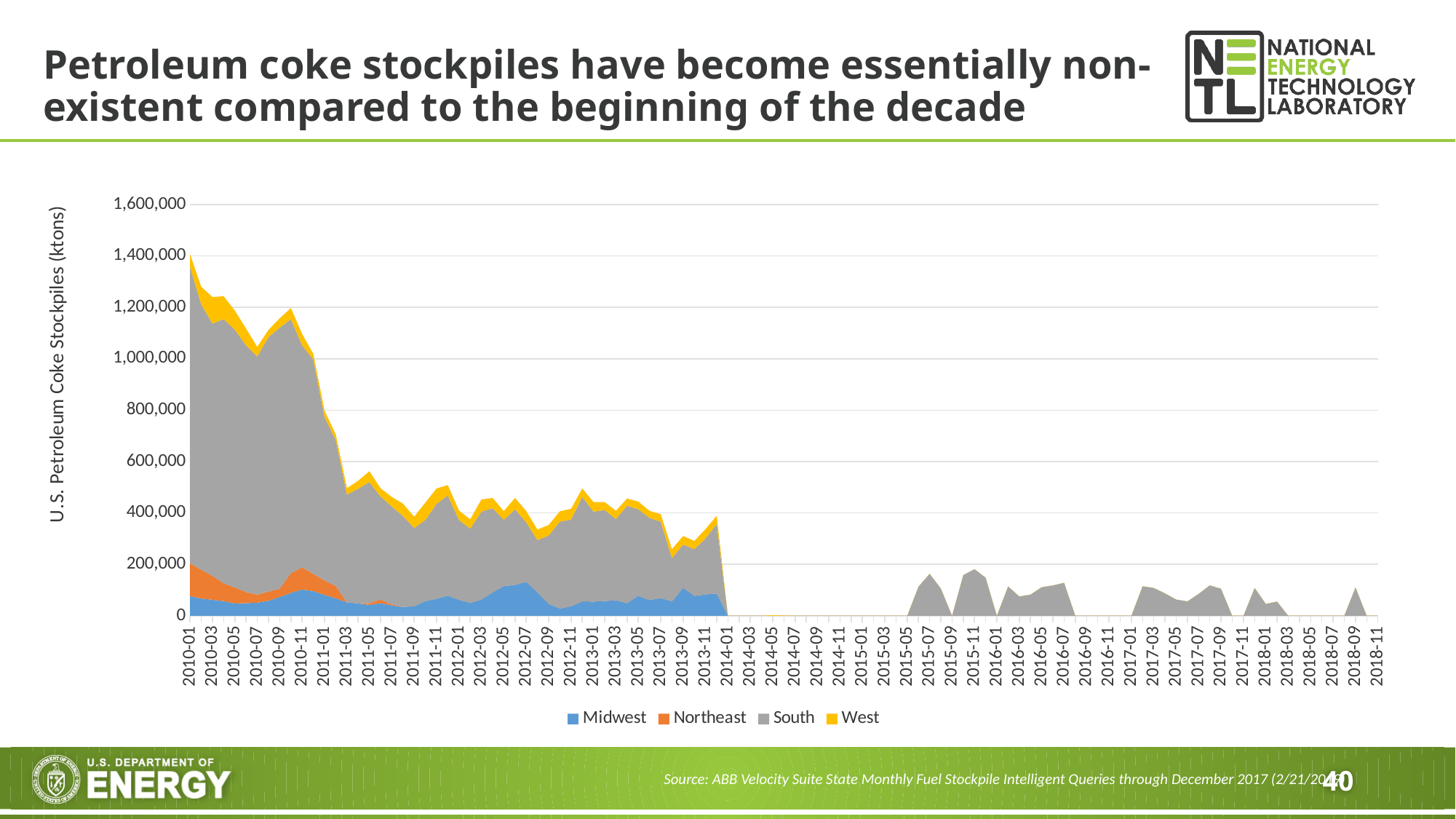
How many series does the legend list? 4 Is the total stockpile value at 2010-01 greater or less than 1,200,000? greater Is the total stockpile value at 2012-07 greater or less than 600,000? less What kind of chart is shown on the slide? Stacked area chart Which regions are listed in the chart legend? Midwest, Northeast, South, West Which region accounts for the largest share of the stockpiles throughout the chart? South Is the total stockpile value at 2010-09 greater or less than 1,000,000? greater Which is larger, the total stockpile value at 2010-01 or at 2013-11? 2010-01 What is the label of the vertical axis? U.S. Petroleum Coke Stockpiles (ktons) Which region is the only one with non-zero stockpiles shown after 2015? South Overall, do the total stockpile values rise or fall from 2010 to 2018? fall